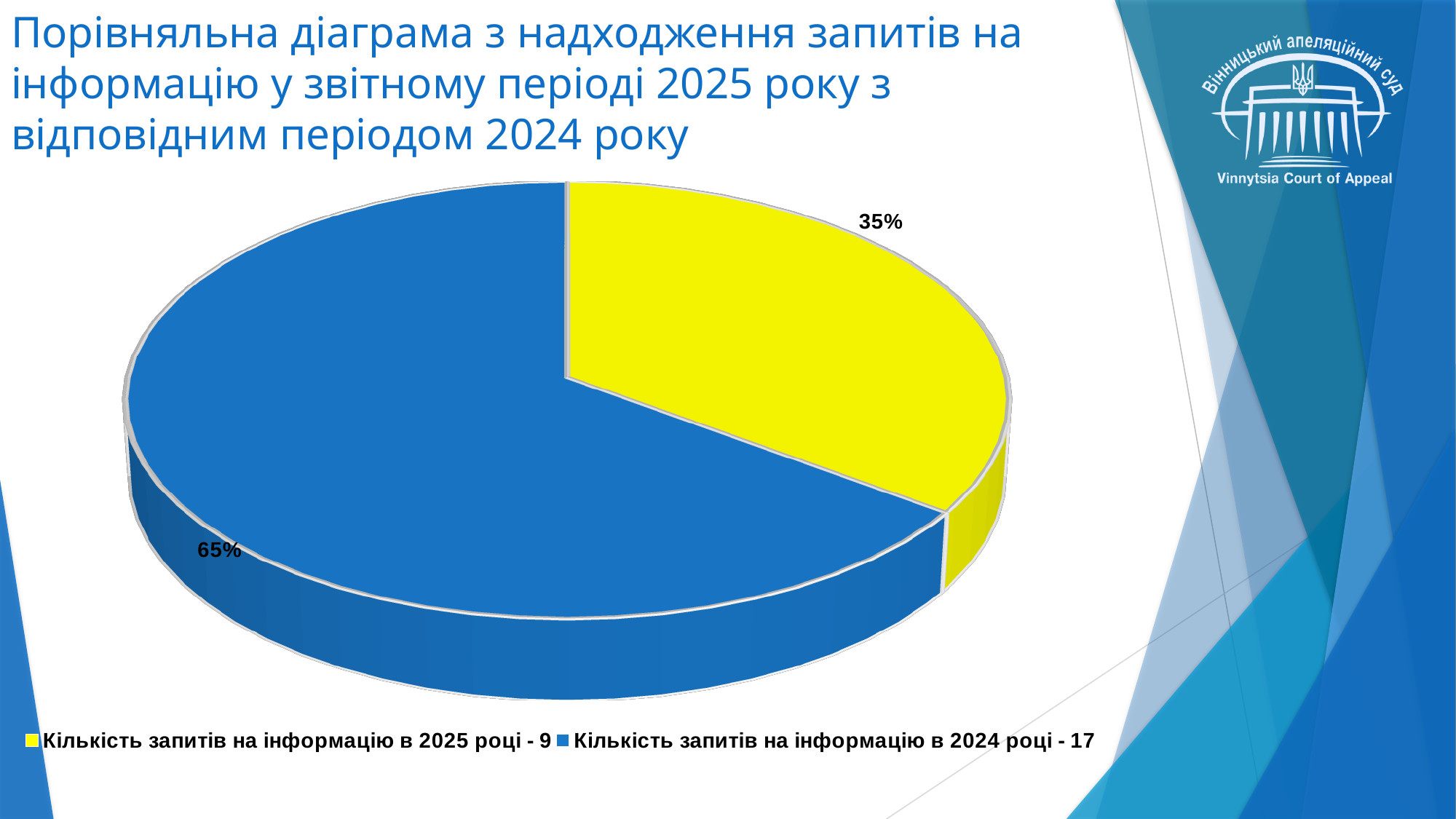
According to the legend, how many requests for information were received in 2024? 17 Which category has the largest share of the pie? Кількість запитів на інформацію в 2024 році What percentage share does the slice for requests for information in 2025 have? 35% Which slice is larger: requests for information in 2025 or in 2024? 2024 How many slices does the pie chart have? 2 What colour is the slice representing requests for information in 2025? yellow How many entries does the legend list? 2 What kind of chart is shown on the slide? pie chart According to the legend, how many requests for information were received in 2025? 9 What is the difference in percentage points between the 2024 share and the 2025 share? 30% Which category has the smallest share of the pie? Кількість запитів на інформацію в 2025 році What percentage share does the slice for requests for information in 2024 have? 65%